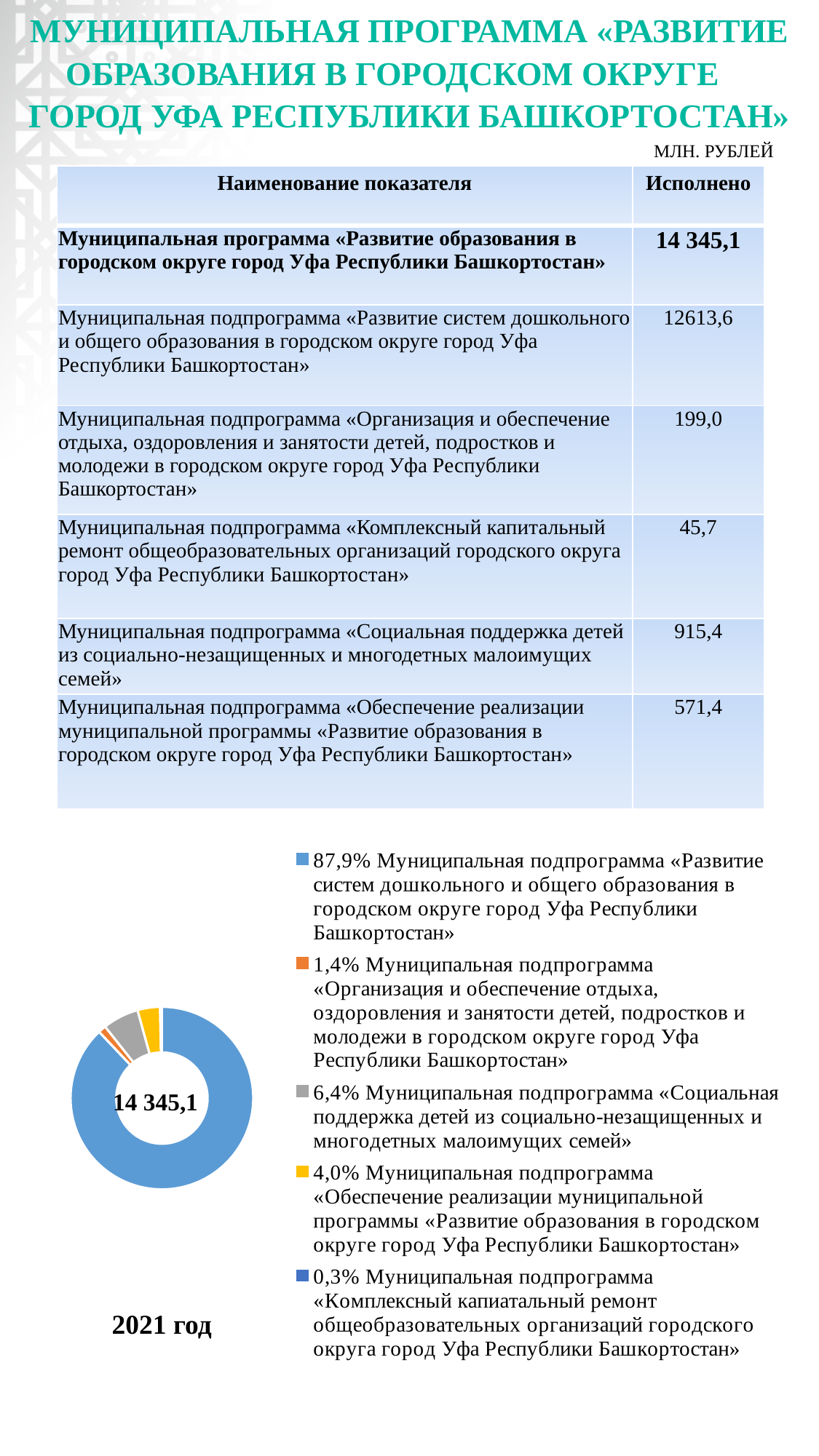
In the doughnut chart, which share is larger: «Социальная поддержка детей» or «Обеспечение реализации муниципальной программы»? Социальная поддержка детей How many slices does the doughnut chart have? 5 Which subprogram has the smallest share in the doughnut chart? Комплексный капитальный ремонт общеобразовательных организаций What share of the doughnut chart does the subprogram «Развитие систем дошкольного и общего образования» take? 87,9% How many entries does the legend of the doughnut chart list? 5 By how many percentage points does the share of «Социальная поддержка детей» exceed the share of «Обеспечение реализации муниципальной программы» in the doughnut chart? 2,4% What share does the subprogram «Социальная поддержка детей из социально-незащищенных и многодетных малоимущих семей» have in the doughnut chart? 6,4% What share does the subprogram «Организация и обеспечение отдыха, оздоровления и занятости детей» have in the doughnut chart? 1,4% What kind of chart is shown at the bottom of the slide? doughnut chart What value is printed in the centre of the doughnut chart? 14 345,1 Which subprogram has the largest share in the doughnut chart? Развитие систем дошкольного и общего образования